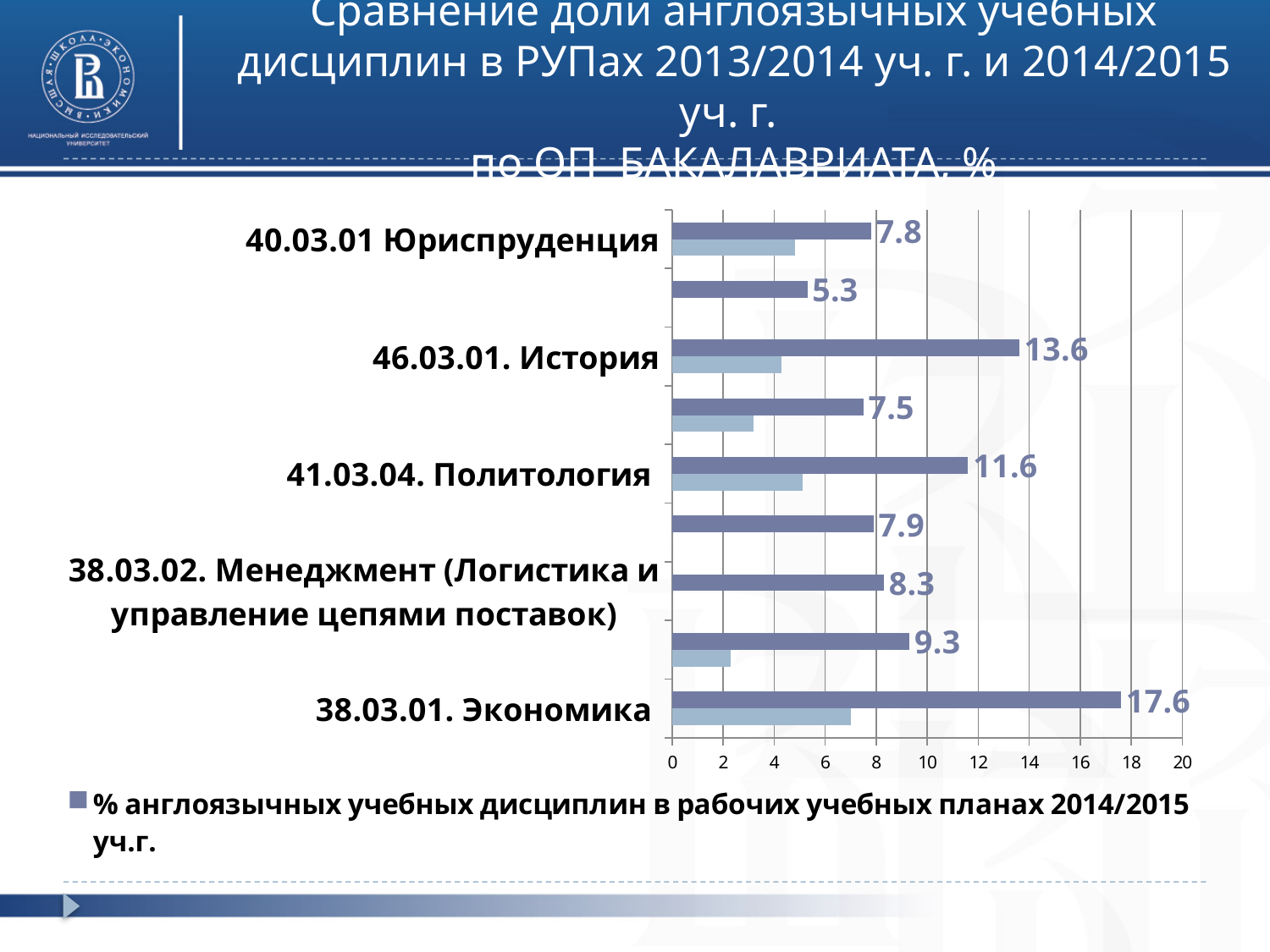
What is the legend entry shown below the chart? % англоязычных учебных дисциплин в рабочих учебных планах 2014/2015 уч.г. What is the value for 38.03.02. Менеджмент (Логистика и управление цепями поставок) in the 2014/2015 series (dark blue bar)? 8.3 How many data labels are printed on the dark blue bars? 9 What is the difference between the 2014/2015 values for 38.03.01. Экономика and 46.03.01. История? 4 What kind of chart is shown on the slide? bar chart Which labelled programme has the highest 2014/2015 value? 38.03.01. Экономика Which has the larger 2014/2015 value: 41.03.04. Политология or 38.03.02. Менеджмент (Логистика и управление цепями поставок)? 41.03.04. Политология What is the value for 46.03.01. История in the 2014/2015 series (dark blue bar)? 13.6 What is the value for 40.03.01 Юриспруденция in the 2014/2015 series (dark blue bar)? 7.8 What is the value for 41.03.04. Политология in the 2014/2015 series (dark blue bar)? 11.6 What is the value for 38.03.01. Экономика in the 2014/2015 series (dark blue bar)? 17.6 Is the light blue (2013/2014) bar for 40.03.01 Юриспруденция greater or less than 6? less